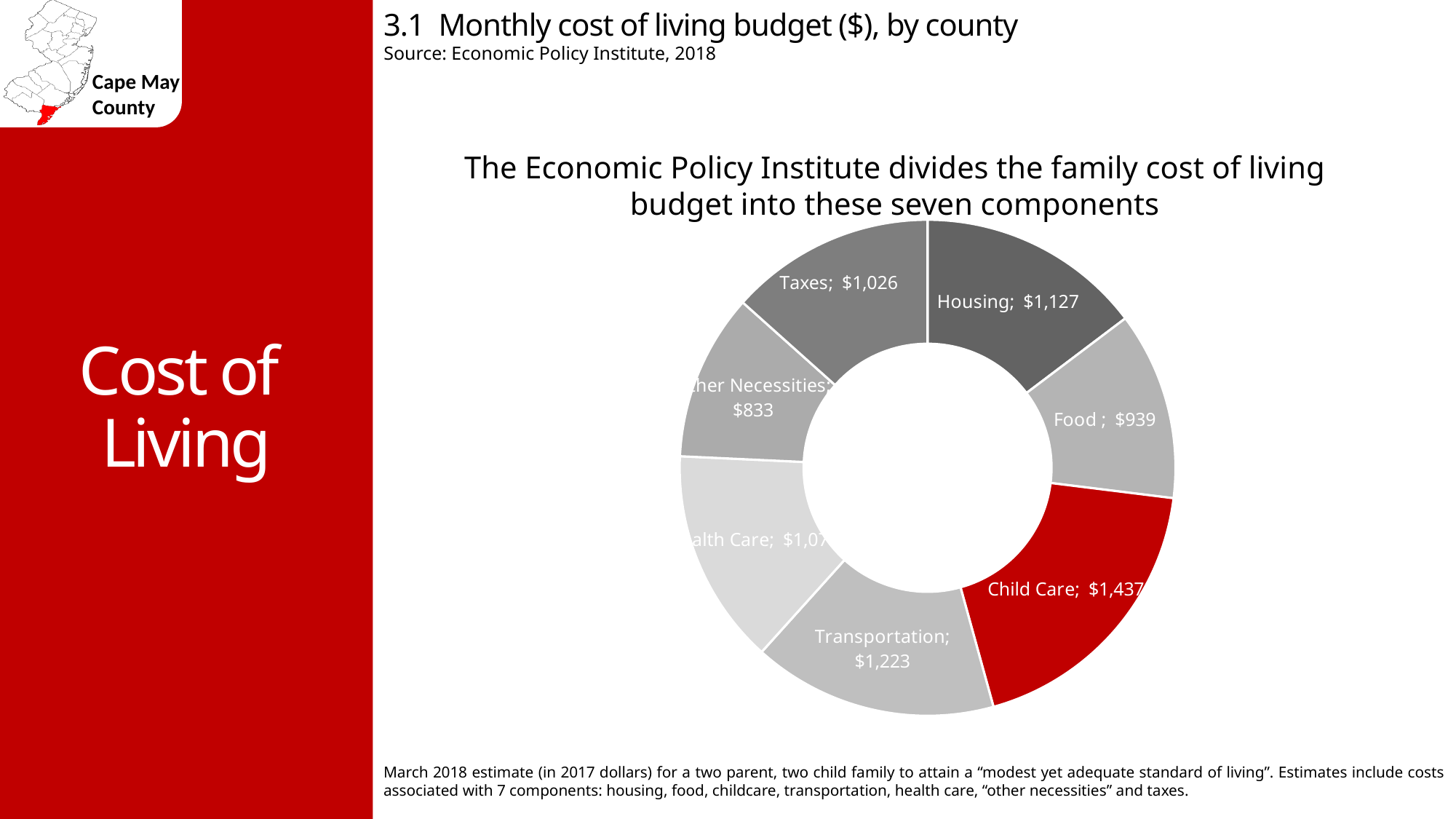
What is the monthly cost for Housing shown on the chart? $1,127 Which has a higher monthly cost, Transportation or Housing? Transportation Which component has the lowest monthly cost? Other Necessities What kind of chart is used on the slide? Pie (doughnut) chart What is the monthly cost for Child Care shown on the chart? $1,437 What is the monthly cost for Transportation shown on the chart? $1,223 What is the monthly cost for Taxes shown on the chart? $1,026 Which component has the highest monthly cost? Child Care How much more is the monthly cost of Transportation than Food? $284 How much more is the monthly cost of Child Care than Housing? $310 What is the monthly cost for Food shown on the chart? $939 How many components are shown in the chart? 7